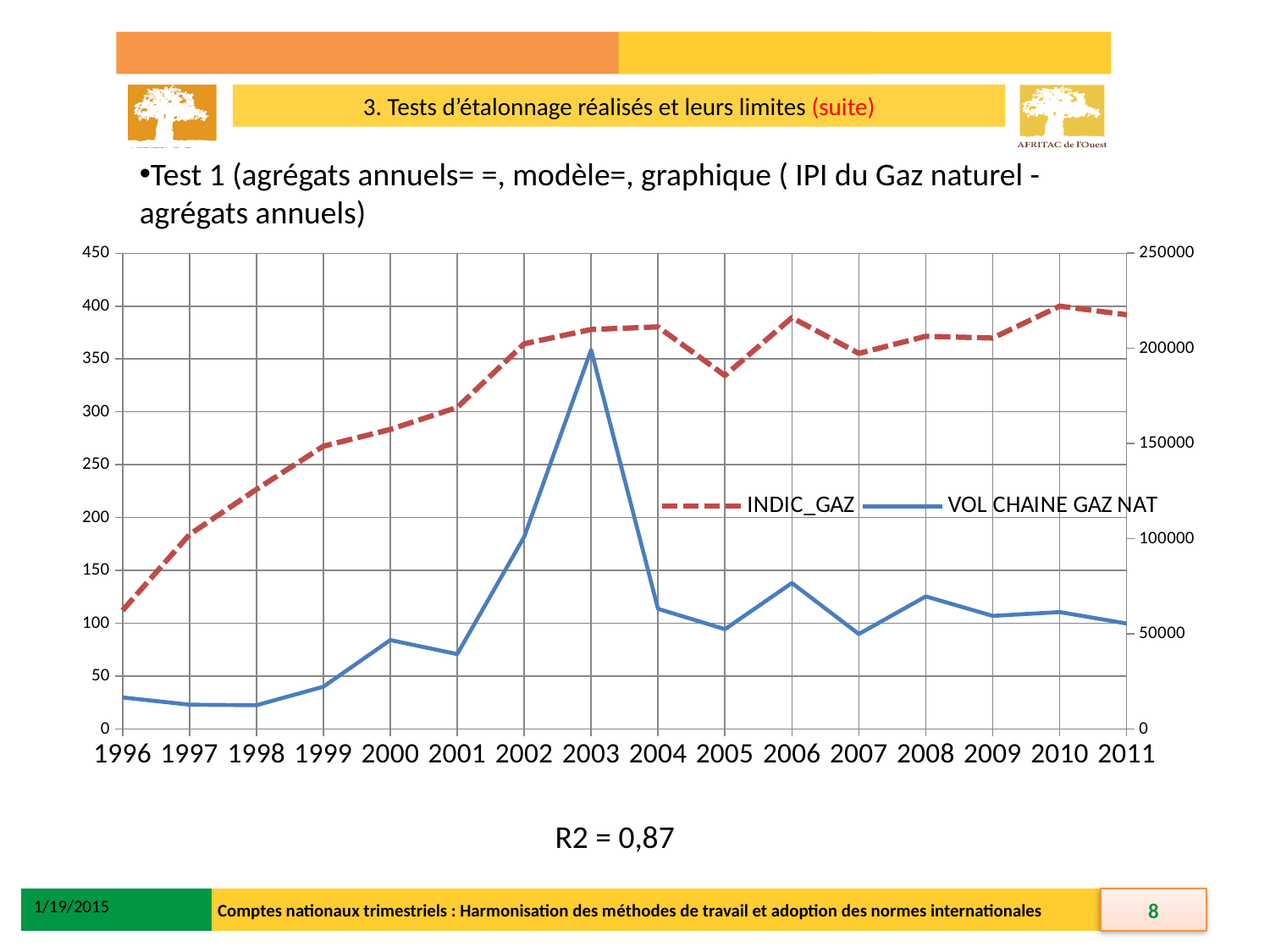
Is the value of VOL CHAINE GAZ NAT in 2005 greater or less than 100000? less Which series is drawn as a dashed line in the chart? INDIC_GAZ What kind of chart is shown on the slide? line chart Which year has the larger INDIC_GAZ value, 2006 or 2007? 2006 Which year has the highest value for VOL CHAINE GAZ NAT? 2003 Is the value of INDIC_GAZ in 1996 greater or less than 150? less How many years are plotted along the x axis of the chart? 16 Is the value of INDIC_GAZ in 2003 greater or less than 350? greater Does INDIC_GAZ rise or fall between 1996 and 2003? rise How many series does the chart legend list? 2 Which year has the lowest value for INDIC_GAZ? 1996